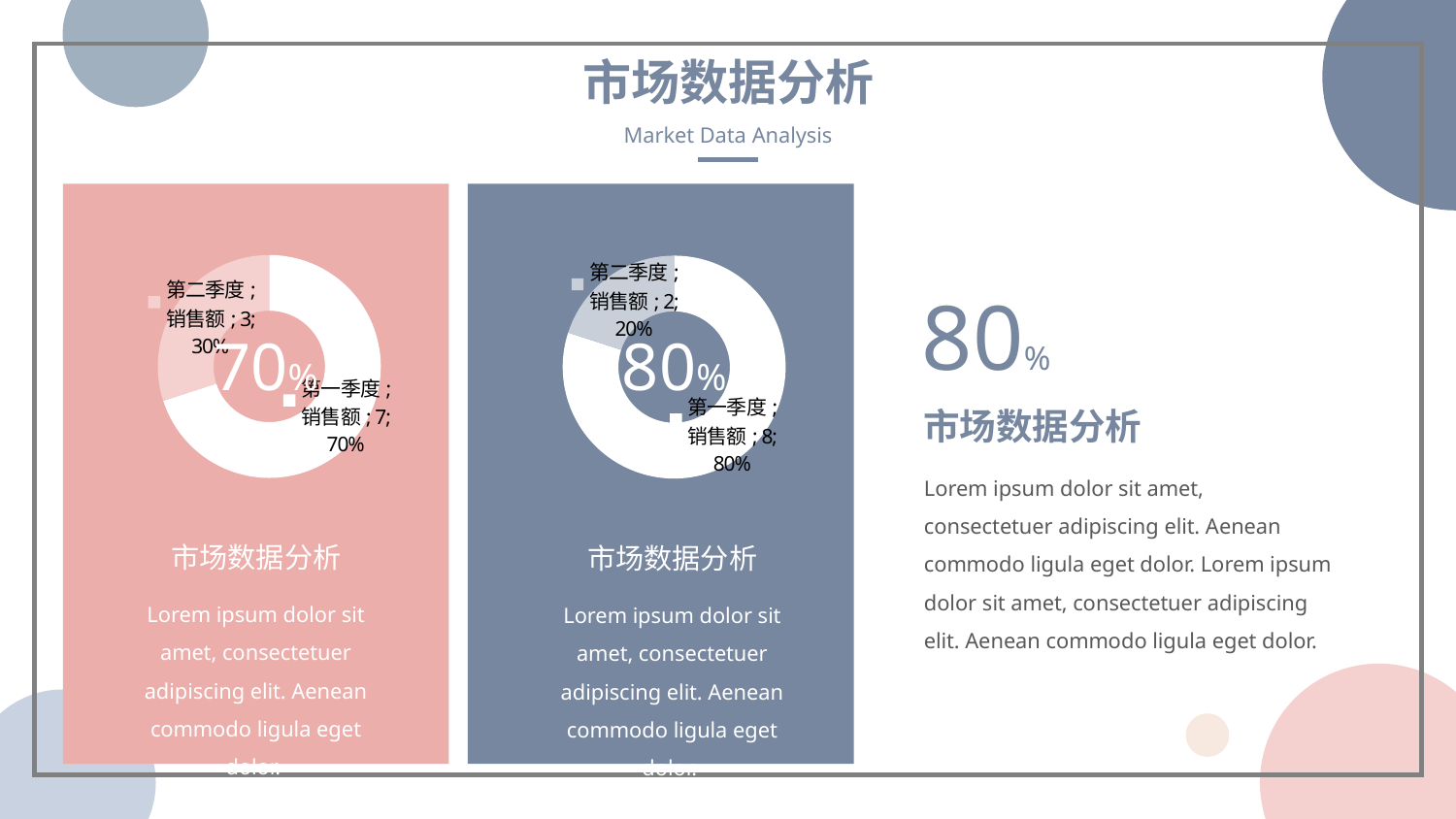
How many slices does the left (pink) donut chart have? 2 On the left (pink) donut chart, what is the difference in 销售额 between 第一季度 and 第二季度? 4 On the middle (blue) donut chart, what percentage is shown for 第二季度? 20% On the middle (blue) donut chart, what is the 销售额 value for 第一季度? 8 Which is larger: the 第一季度 share on the left (pink) chart or the 第一季度 share on the middle (blue) chart? the middle (blue) chart On the middle (blue) donut chart, which quarter has the smallest share? 第二季度 What is the large percentage printed in the center of the middle (blue) donut chart? 80% On the left (pink) donut chart, what is the 销售额 value for 第二季度? 3 On the middle (blue) donut chart, what is the difference in percentage between 第一季度 and 第二季度? 60% What type of chart is the middle (blue) chart? donut (pie) chart On the left (pink) donut chart, what percentage is shown for 第一季度? 70% On the left (pink) donut chart, which quarter has the larger share? 第一季度